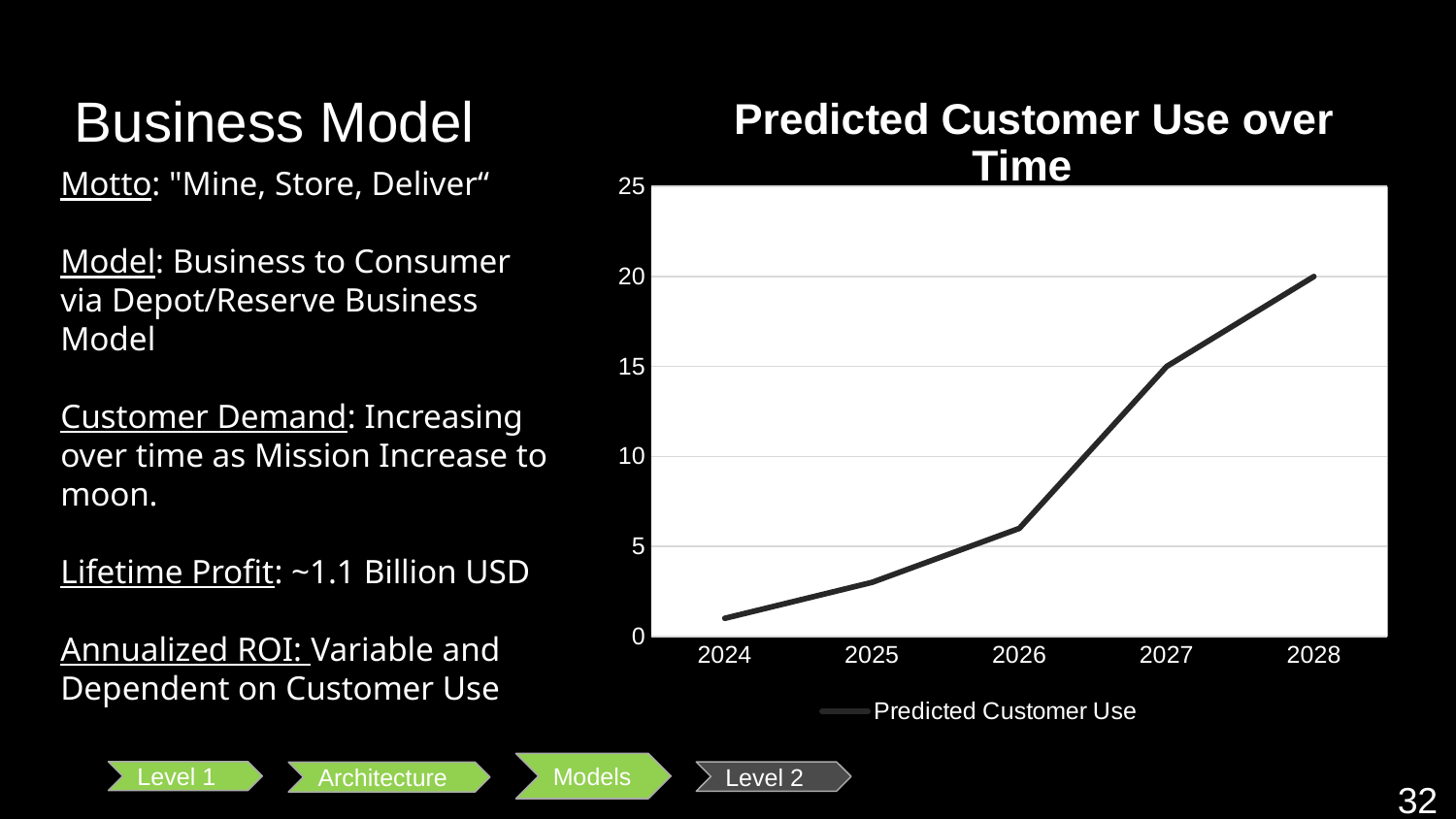
How many years are plotted on the x axis? 5 Which year has the highest predicted customer use? 2028 Which year has the lowest predicted customer use? 2024 What is the title of the chart? Predicted Customer Use over Time Is the value for 2025 greater or less than 5? less Do the values rise or fall from 2024 to 2028? rise What is the difference between the predicted customer use in 2028 and in 2027? 5 Is the value for 2026 greater or less than 10? less What is the predicted customer use for 2027? 15 How many series does the legend list? 1 What is the predicted customer use for 2028? 20 What kind of chart is shown on the slide? line chart